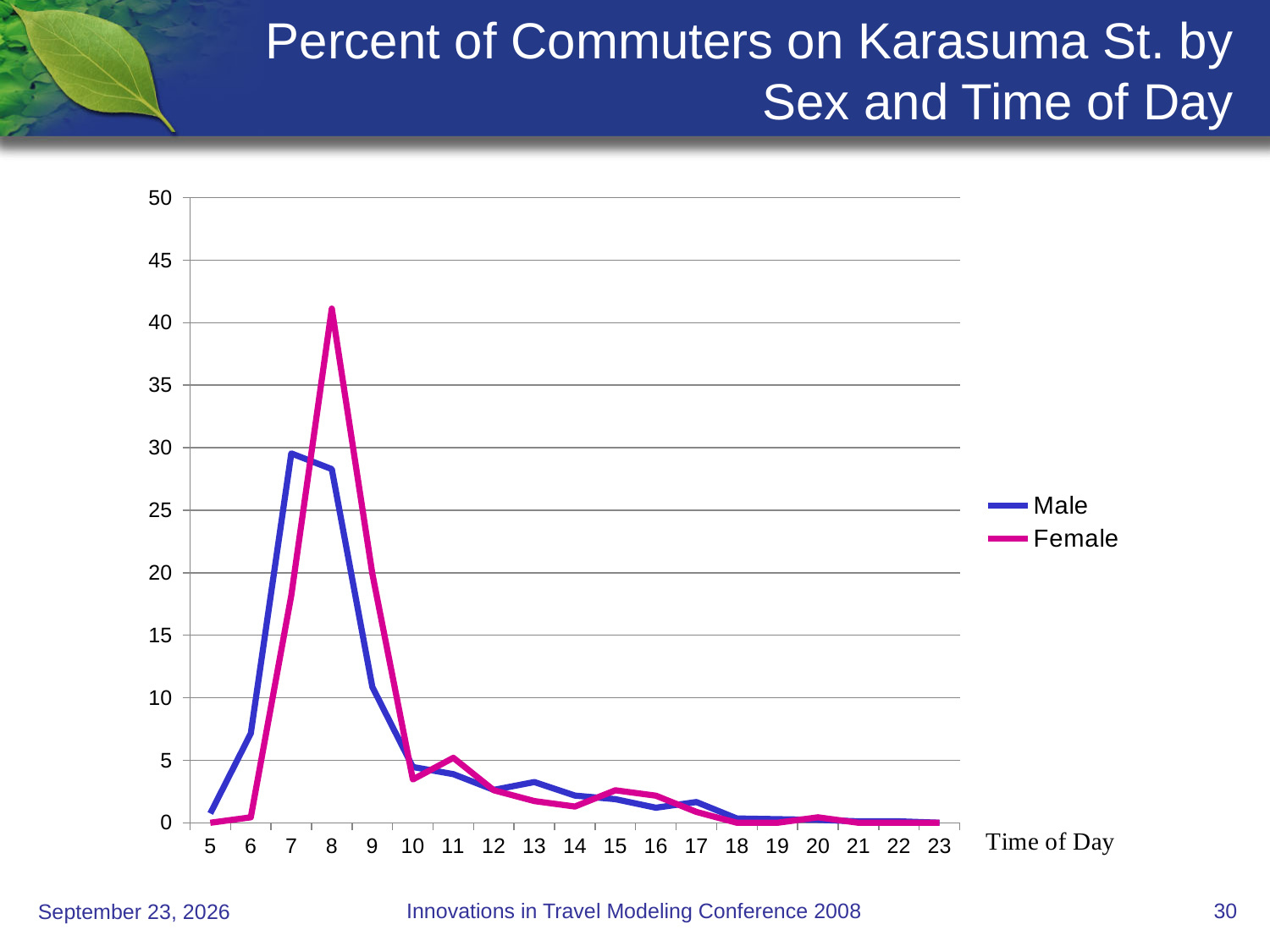
At which time of day does the Female series reach its highest value? 8 Is the Female value at 6 greater or less than 5? less Is the Female value at 8 greater or less than 40? greater What kind of chart is shown on the slide? line chart At which time of day does the Male series reach its highest value? 7 At 6, which series has the larger value, Male or Female? Male Is the Male value at 9 greater or less than 10? greater How many time-of-day points are plotted along the x axis? 19 Which colour is used for the Female series? magenta (pink) At 8, which series has the larger value, Male or Female? Female How many series does the legend list? 2